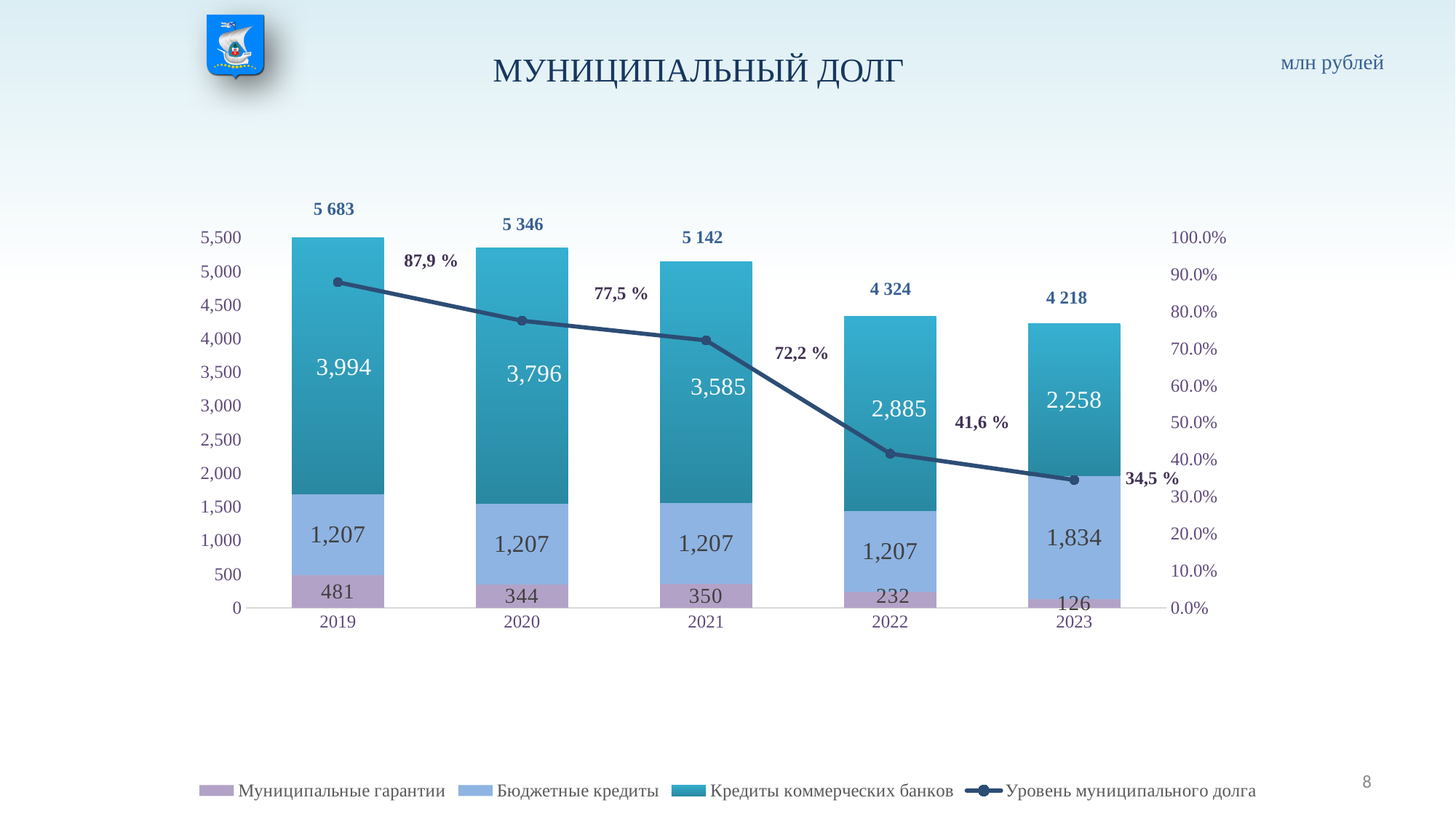
Which year has the highest total municipal debt? 2019 What is the Уровень муниципального долга for 2022? 41,6 % Does the Уровень муниципального долга line rise or fall from 2019 to 2023? fall Which year has the lowest value for Муниципальные гарантии? 2023 What is the value of Муниципальные гарантии for 2019? 481 What is the value of Кредиты коммерческих банков for 2021? 3,585 What is the value of Бюджетные кредиты for 2023? 1,834 How many series does the legend list? 4 What is the difference between the Кредиты коммерческих банков values for 2019 and 2023? 1,736 Which is larger, Муниципальные гарантии in 2020 or in 2021? 2021 What is the total of the stacked bar for 2020? 5 346 How many years are shown on the x axis? 5